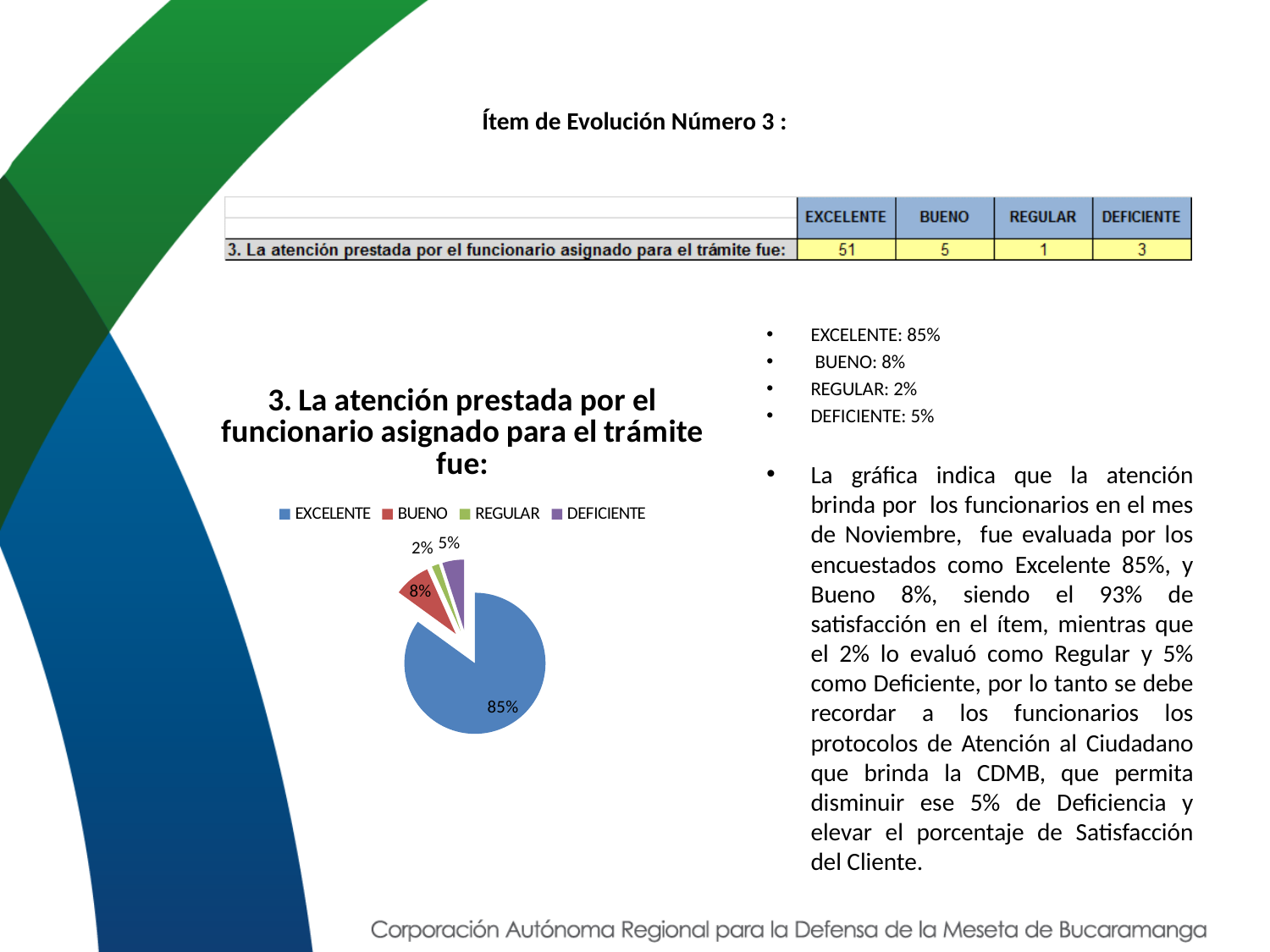
What share of the pie does REGULAR represent? 2% What kind of chart is shown on the slide? pie chart How many categories does the pie chart legend list? 4 Which category has the smallest slice of the pie? REGULAR What is the title of the pie chart? 3. La atención prestada por el funcionario asignado para el trámite fue: What share of the pie does BUENO represent? 8% What is the difference in percentage points between the EXCELENTE and BUENO slices? 77 Which colour is used for the EXCELENTE slice in the pie chart? blue What share of the pie does DEFICIENTE represent? 5% Which category has the largest slice of the pie? EXCELENTE Which slice is larger, BUENO or DEFICIENTE? BUENO